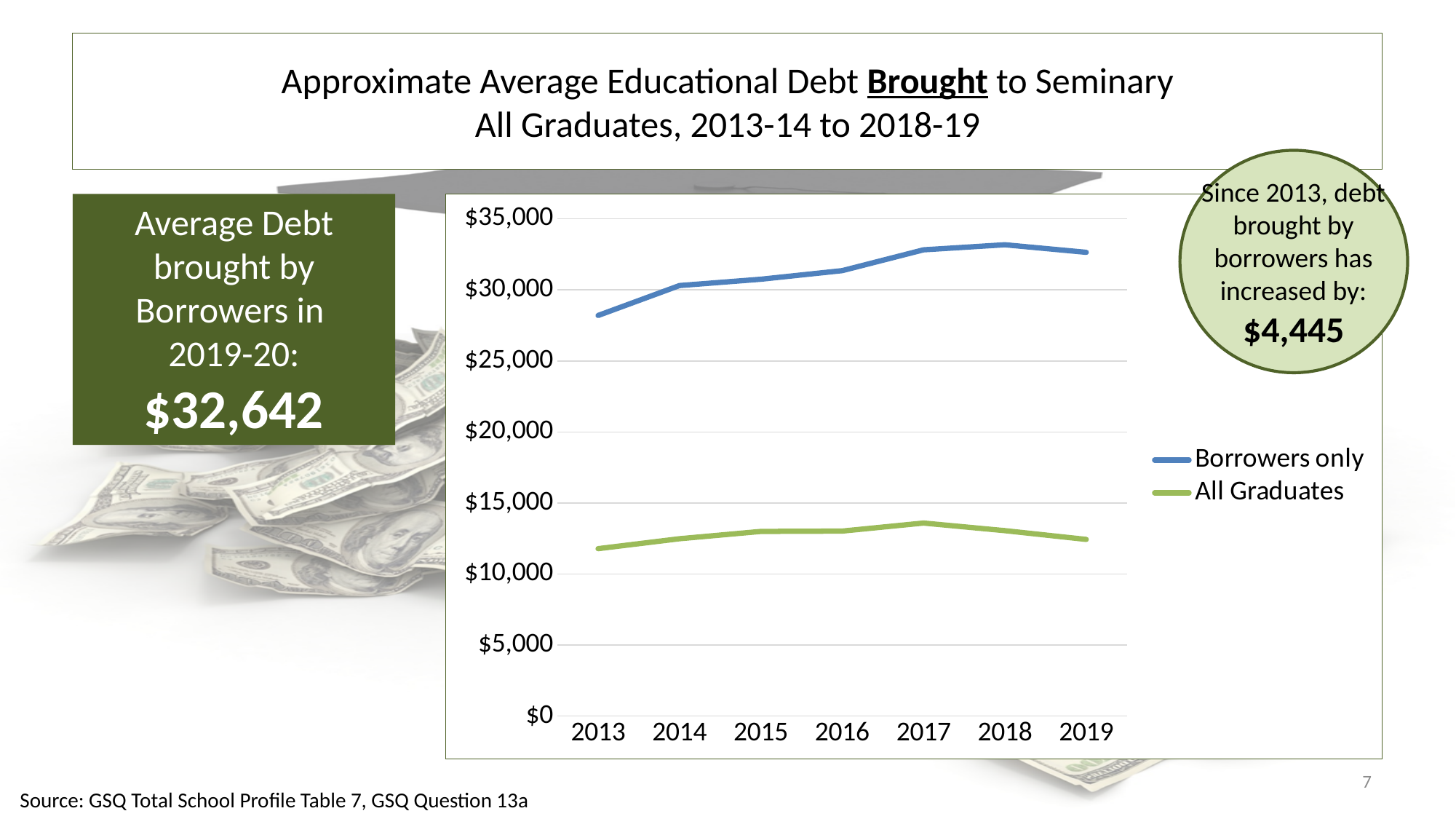
Is the value for All Graduates in 2019 greater or less than $15,000? less Does the Borrowers only line generally rise or fall from 2013 to 2018? Rise How many years are plotted along the x axis of the chart? 7 How many series does the chart's legend list? 2 What kind of chart is shown on the slide? Line chart In which year is the Borrowers only line at its highest? 2018 Is the value for Borrowers only in 2013 greater or less than $30,000? less In 2015, which series has the larger value, Borrowers only or All Graduates? Borrowers only In which year is the All Graduates line at its highest? 2017 In which year is the Borrowers only line at its lowest? 2013 In which year is the All Graduates line at its lowest? 2013 Is the value for Borrowers only in 2017 greater or less than $30,000? greater